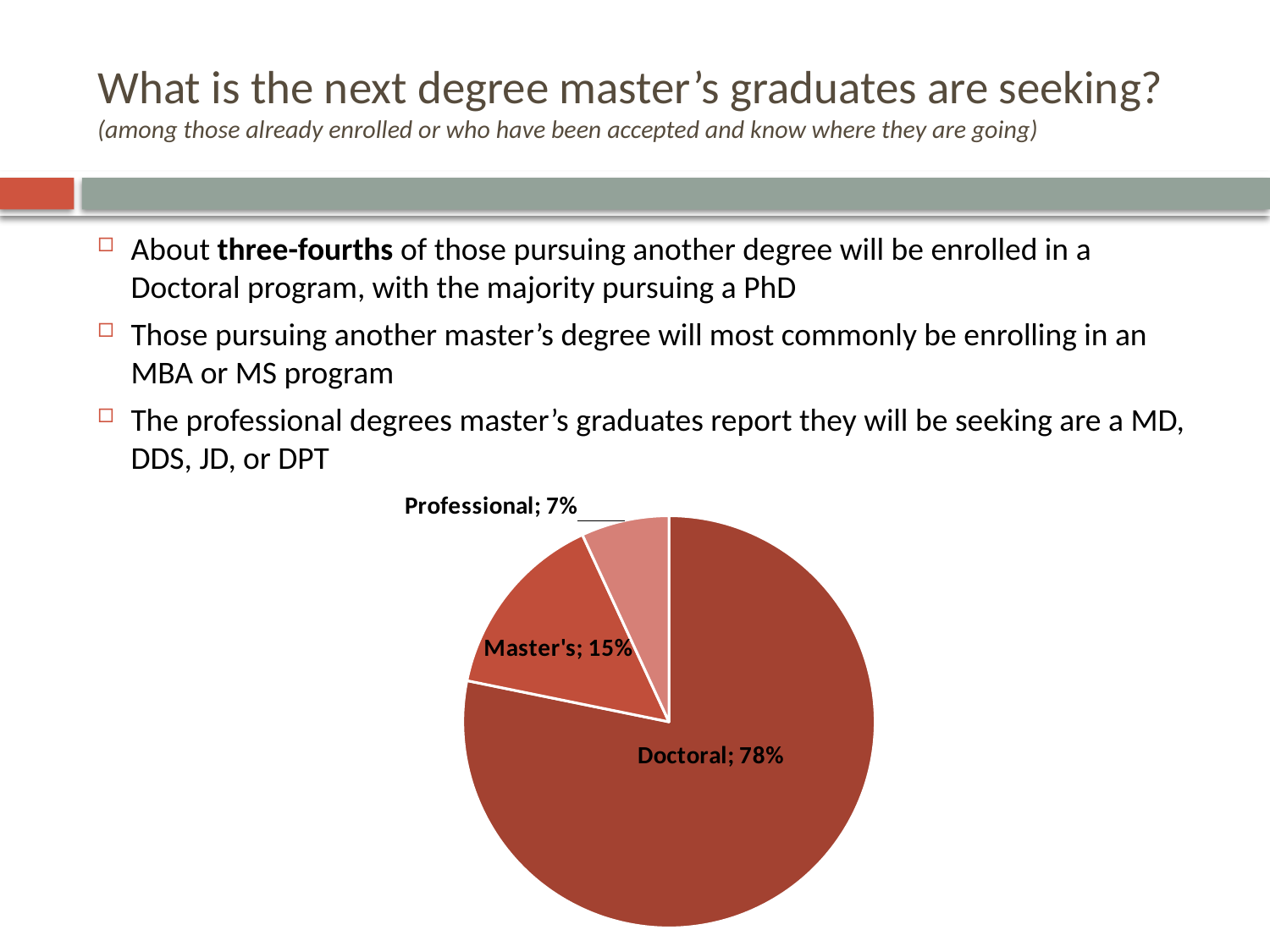
What is the combined share of the Master's and Professional slices? 22% Which category has the largest slice of the pie? Doctoral What is the difference in percentage points between the Doctoral and Master's slices? 63 Which category has the smallest slice of the pie? Professional What share of the pie does Master's represent? 15% What share of the pie does Doctoral represent? 78% Is the Doctoral slice greater or less than 50% of the pie? greater How many categories are shown in the pie chart? 3 Which is larger, the Master's slice or the Professional slice? Master's What kind of chart is shown on the slide? Pie chart What is the difference in percentage points between the Master's and Professional slices? 8 What share of the pie does Professional represent? 7%